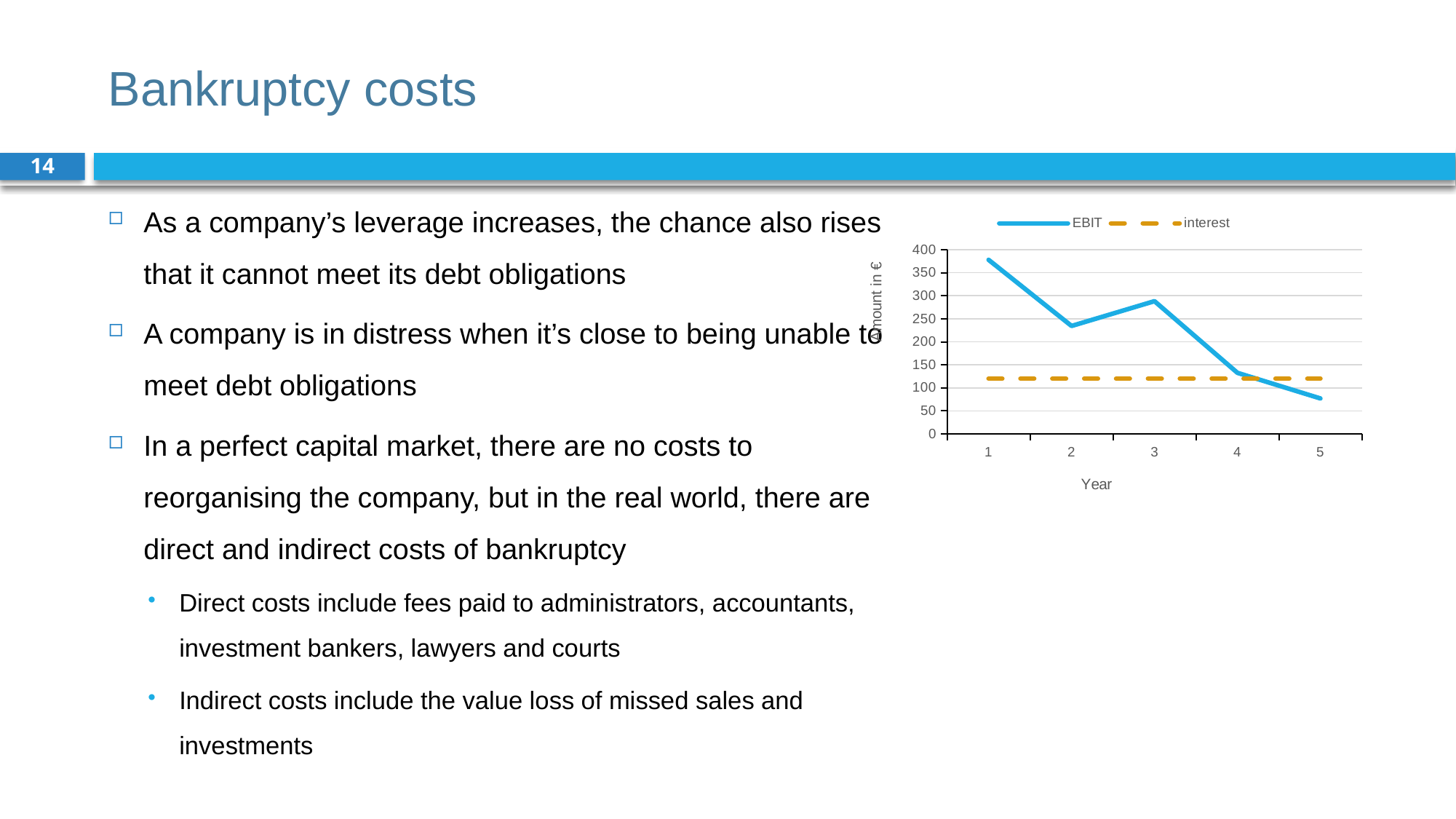
What is the title of the chart's y axis? Amount in € In which year is EBIT highest? 1 Which is larger, EBIT in year 1 or EBIT in year 3? EBIT in year 1 Is the EBIT value for year 1 greater or less than 350? greater In year 5, which is larger, EBIT or interest? interest Is the interest value greater or less than 150? less How many series does the chart's legend list? 2 Does the interest line rise, fall or stay flat across the years? stay flat In which year is EBIT lowest? 5 How many years are plotted along the x axis of the chart? 5 Is the EBIT value for year 5 greater or less than 100? less What kind of chart is shown on the slide? line chart